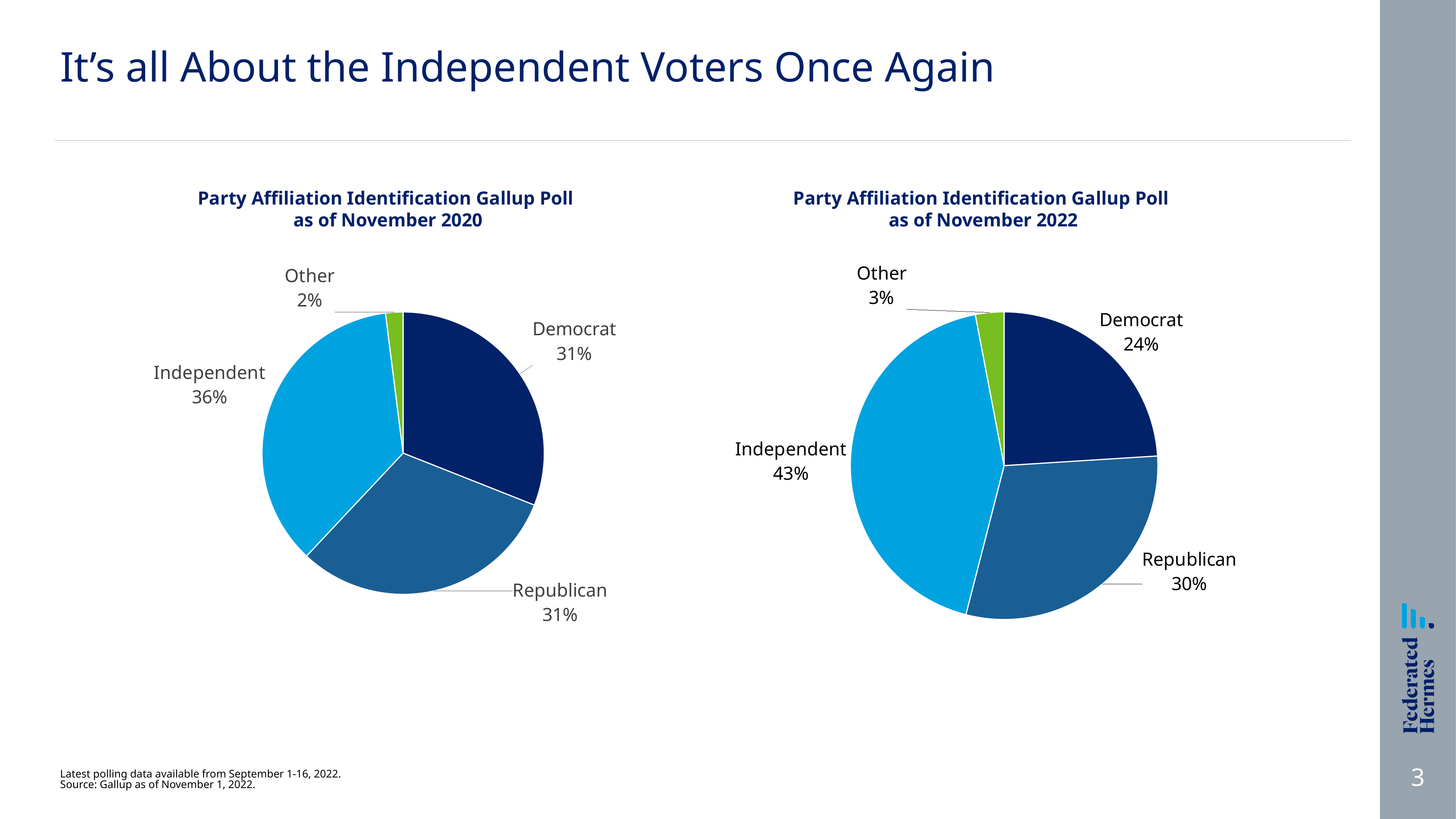
In the 'Party Affiliation Identification Gallup Poll as of November 2020' chart, what share is Other? 2% How many categories does the 'Party Affiliation Identification Gallup Poll as of November 2020' chart show? 4 In the 'Party Affiliation Identification Gallup Poll as of November 2020' chart, what share is Republican? 31% What is the title of the chart on the left of the slide? Party Affiliation Identification Gallup Poll as of November 2020 In the 'Party Affiliation Identification Gallup Poll as of November 2022' chart, which category has the largest share? Independent In the 'Party Affiliation Identification Gallup Poll as of November 2022' chart, what is the difference between the Republican and Democrat shares? 6% In the 'Party Affiliation Identification Gallup Poll as of November 2020' chart, which category has the smallest share? Other In the 'Party Affiliation Identification Gallup Poll as of November 2022' chart, what share is Independent? 43% In the 'Party Affiliation Identification Gallup Poll as of November 2020' chart, what share is Independent? 36% What kind of chart is the 'Party Affiliation Identification Gallup Poll as of November 2022' chart? pie chart In the 'Party Affiliation Identification Gallup Poll as of November 2022' chart, which is larger, Republican or Democrat? Republican In the 'Party Affiliation Identification Gallup Poll as of November 2022' chart, what share is Democrat? 24%